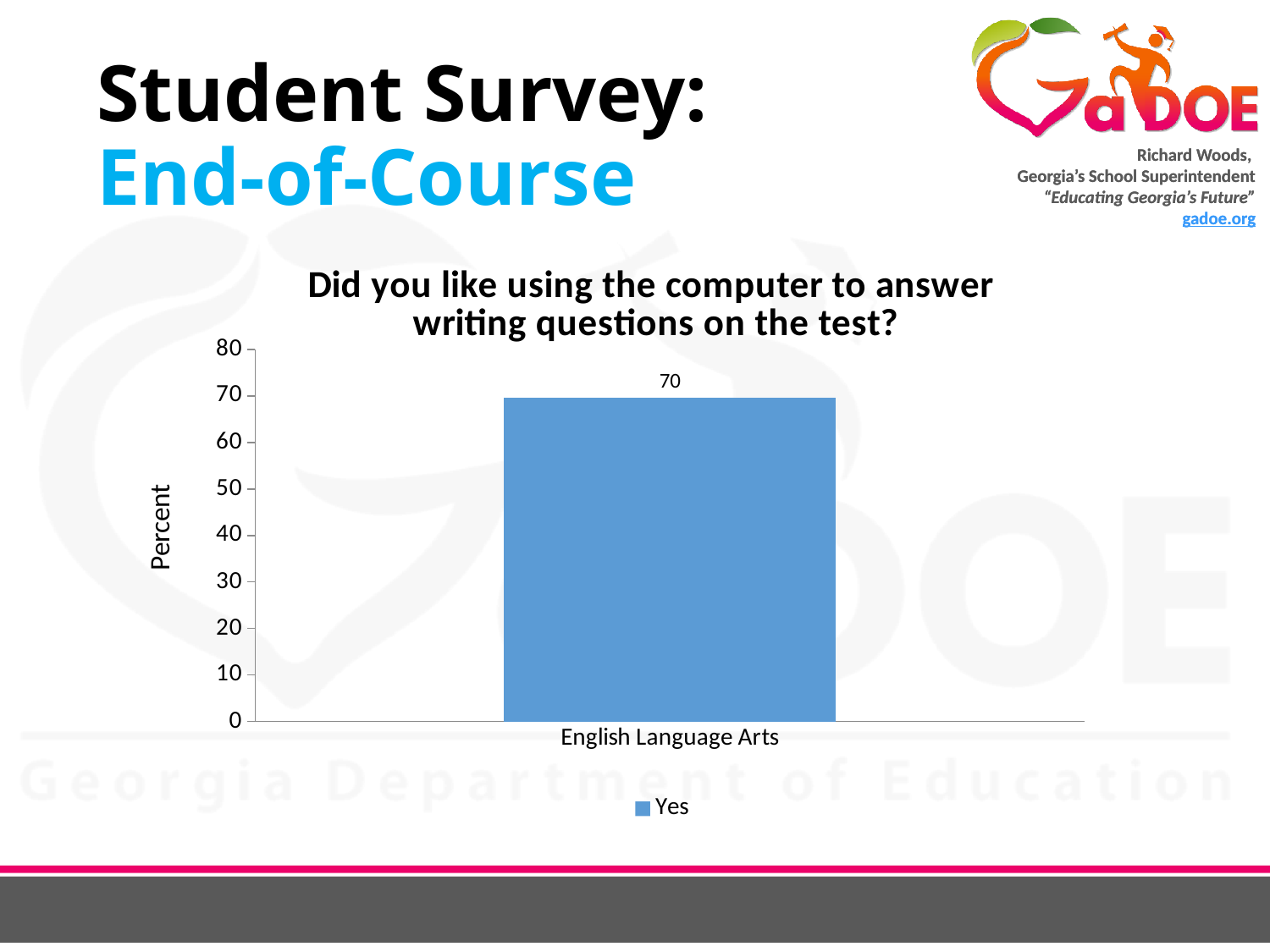
What kind of chart is shown? bar chart What is the title of the chart? Did you like using the computer to answer writing questions on the test? What is the label on the y axis? Percent How many categories are shown on the x axis? 1 How many series does the legend list? 1 What is the value for English Language Arts? 70 Is the value for English Language Arts greater or less than 80? less Is the value for English Language Arts greater or less than 60? greater What percent of students answered Yes for English Language Arts? 70 What is the maximum value shown on the y axis? 80